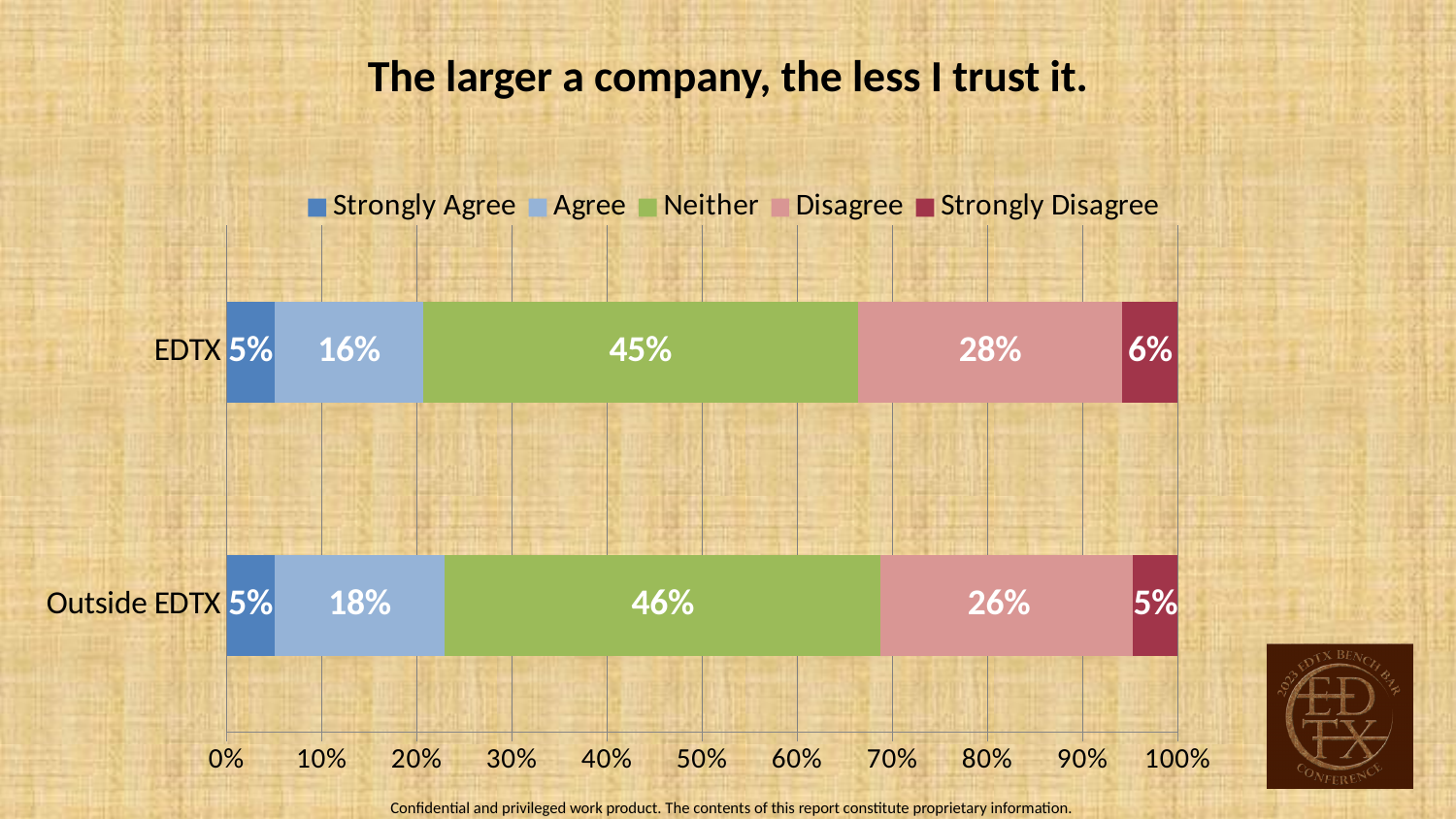
What percentage of Outside EDTX respondents answered Disagree? 26% What is the title of the chart? The larger a company, the less I trust it. What percentage of Outside EDTX respondents answered Agree? 18% What percentage of EDTX respondents answered Neither? 45% How many categories (bars) are shown on the chart? 2 Which group has a higher Agree percentage, EDTX or Outside EDTX? Outside EDTX How many series does the legend list? 5 What kind of chart is shown on the slide? Stacked bar chart Which response category has the smallest share for EDTX? Strongly Agree What is the difference between the Disagree percentages for EDTX and Outside EDTX? 2% Which response category has the largest share for Outside EDTX? Neither What percentage of EDTX respondents answered Strongly Disagree? 6%